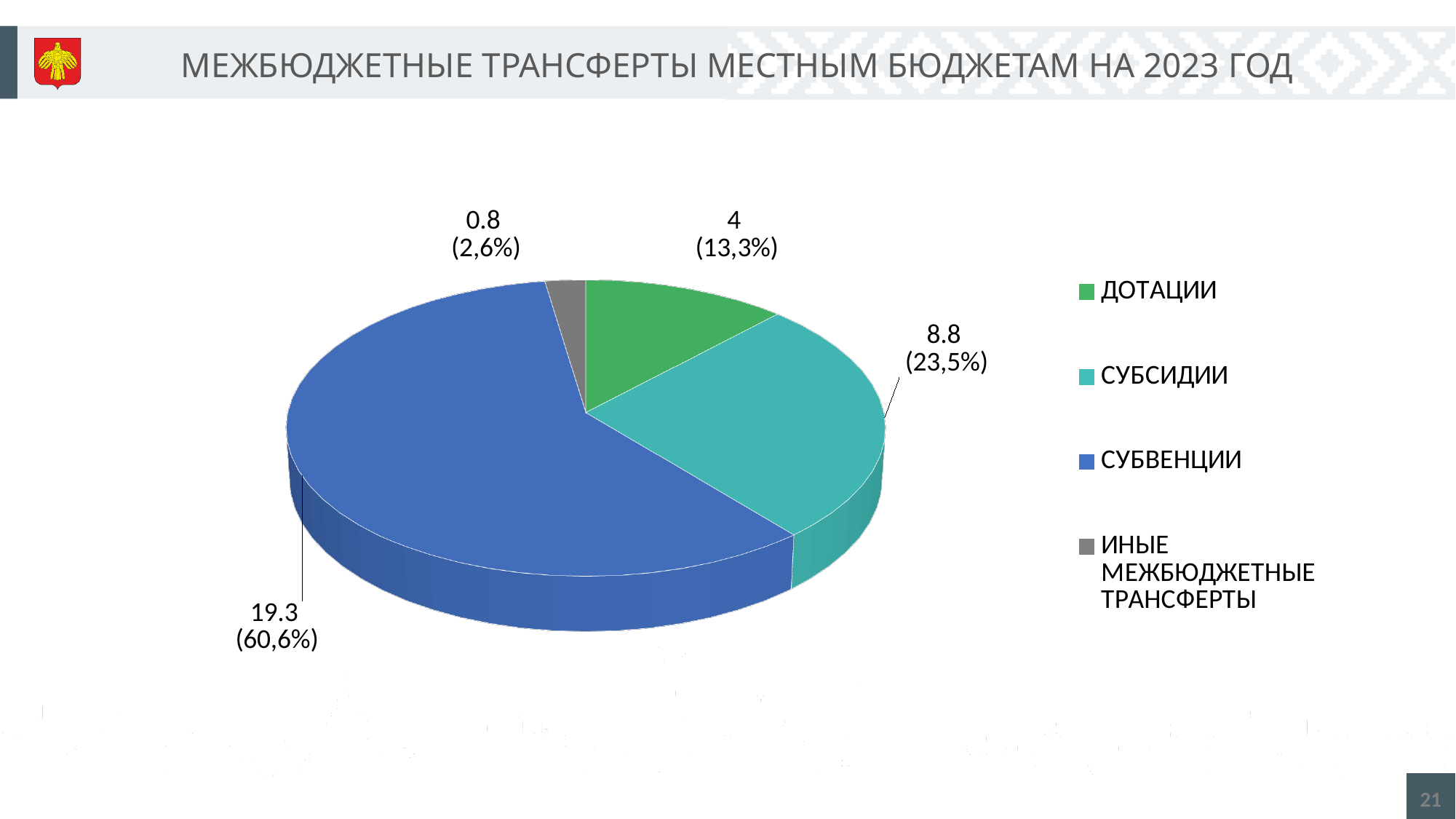
What is the value for СУБВЕНЦИИ? 19.3 What share of the pie does СУБВЕНЦИИ represent? 60,6% What is the value for СУБСИДИИ? 8.8 What share of the pie does ДОТАЦИИ represent? 13,3% Which category has the smallest slice? ИНЫЕ МЕЖБЮДЖЕТНЫЕ ТРАНСФЕРТЫ What is the value for ИНЫЕ МЕЖБЮДЖЕТНЫЕ ТРАНСФЕРТЫ? 0.8 Which is larger, the value for СУБСИДИИ or the value for ДОТАЦИИ? СУБСИДИИ Which category has the largest slice? СУБВЕНЦИИ How many categories does the legend list? 4 What is the value for ДОТАЦИИ? 4 What type of chart is shown on the slide? Pie chart What is the difference between the values for СУБВЕНЦИИ and СУБСИДИИ? 10.5